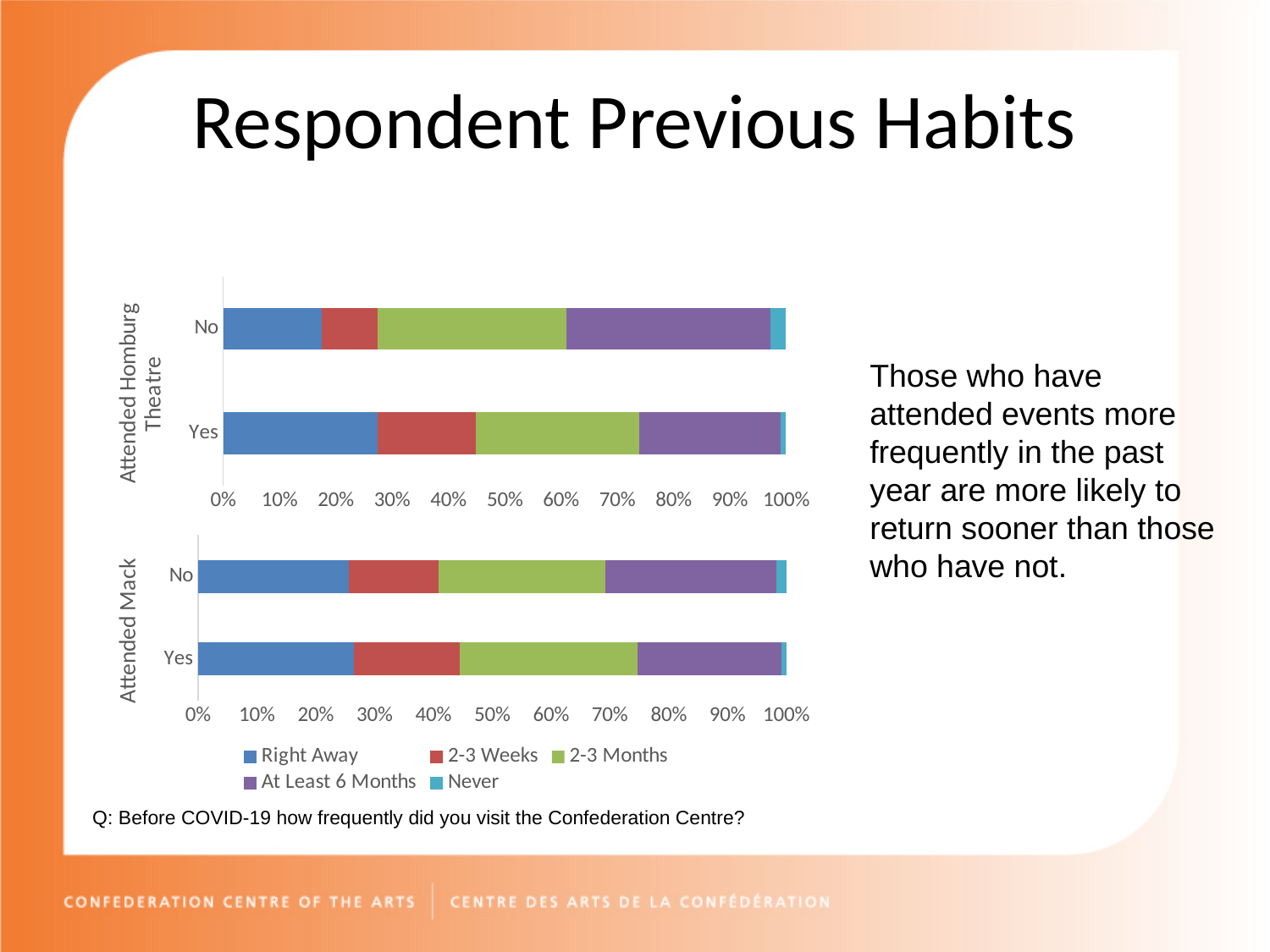
How many categories are shown on the 'Attended Mack' chart? 2 In the 'Attended Homburg Theatre' chart, is the 'Right Away' value for 'No' greater or less than 20%? less Which series is shown in blue in the legend? Right Away In the 'Attended Homburg Theatre' chart, which category has the larger 'Right Away' share, 'Yes' or 'No'? Yes What is the maximum value shown on the x axis of the 'Attended Mack' chart? 100% In the 'Attended Homburg Theatre' chart, which category has the larger '2-3 Weeks' share, 'Yes' or 'No'? Yes In the 'Attended Mack' chart, is the 'Right Away' value for 'No' greater or less than 20%? greater In the 'Attended Homburg Theatre' chart, which category has the larger 'At Least 6 Months' share, 'Yes' or 'No'? No What kind of chart is the 'Attended Homburg Theatre' chart? Stacked bar chart In the 'Attended Homburg Theatre' chart, is the 'Right Away' value for 'Yes' greater or less than 20%? greater How many series does the legend list for the charts? 5